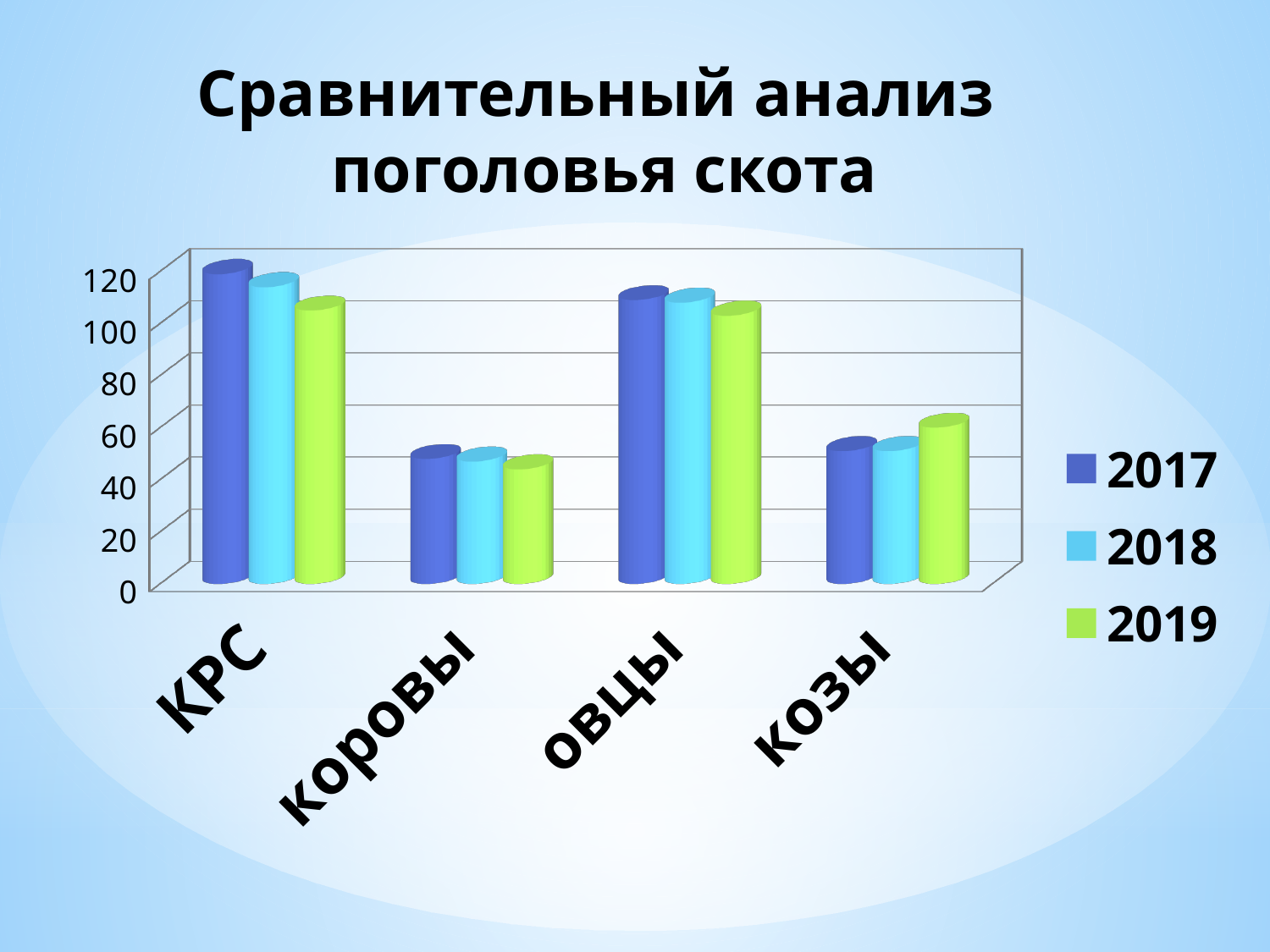
Which category has the highest value for 2017? КРС Is the value for коровы in 2017 greater or less than 80? less Is the value for КРС in 2017 greater or less than 100? greater Which years are listed in the legend? 2017, 2018, 2019 What is the title of the chart? Сравнительный анализ поголовья скота Do the values for КРС rise or fall from 2017 to 2019? fall How many series does the legend list? 3 Which is larger: the 2017 value for КРС or the 2017 value for коровы? КРС What kind of chart is shown on the slide? bar chart Which category has the lowest value for 2019? коровы How many categories are shown on the x axis? 4 Is the value for овцы in 2019 greater or less than 80? greater